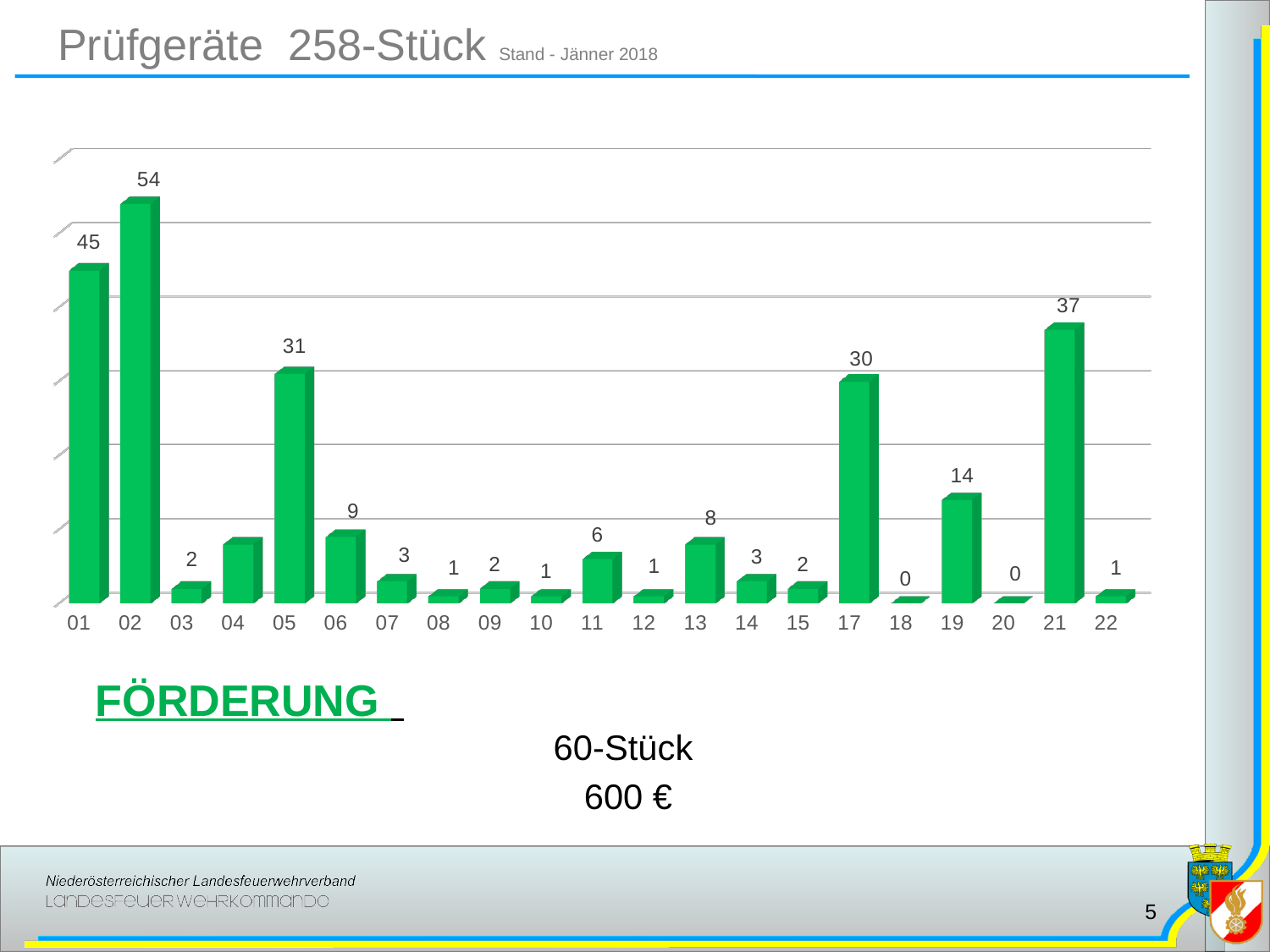
What is the difference between the values for categories 21 and 17? 7 What is the value for category 21? 37 What colour are the bars in the chart? green What is the value for category 17? 30 What is the value for category 02? 54 What is the value for category 19? 14 What kind of chart is shown on the slide? bar chart Which has the larger value, category 01 or category 21? 01 Which has the larger value, category 05 or category 17? 05 What is the difference between the values for categories 02 and 01? 9 Which category has the highest value? 02 How many categories are shown on the x axis? 21